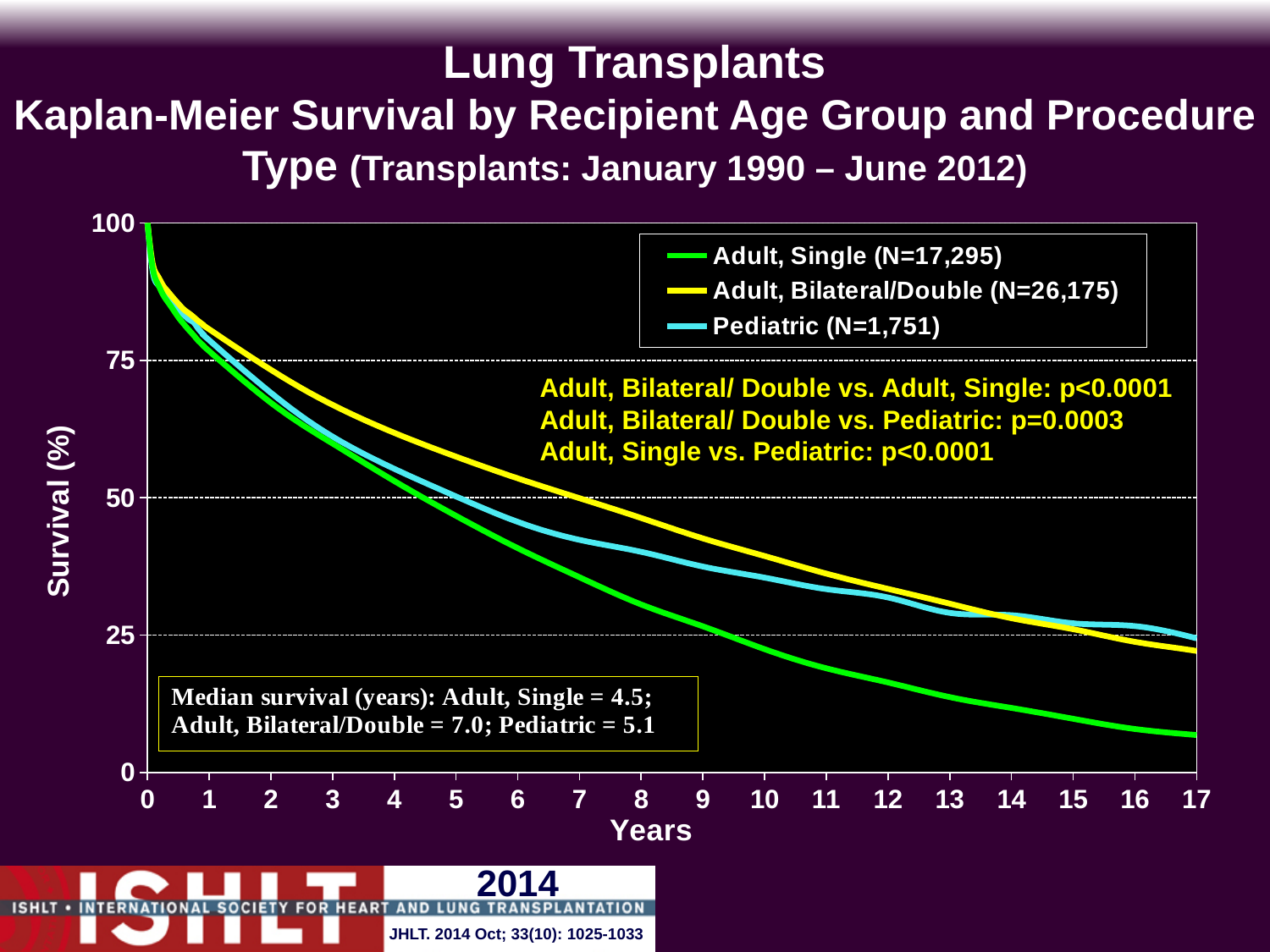
Do the survival curves rise or fall as years increase? fall How many series does the legend list? 3 What is the N for the Pediatric group shown in the legend? 1,751 At 10 years, which has higher survival: Adult, Bilateral/Double or Adult, Single? Adult, Bilateral/Double What kind of chart is shown on the slide? line chart What is the median survival in years for Pediatric recipients? 5.1 Which group has the highest median survival? Adult, Bilateral/Double What is the difference in median survival (years) between Adult, Bilateral/Double and Adult, Single? 2.5 Is the survival for Adult, Bilateral/Double at 10 years greater or less than 50? less What is the median survival in years for Adult, Bilateral/Double recipients? 7.0 Which group has the lowest median survival? Adult, Single Is the survival for Adult, Single at 15 years greater or less than 25? less